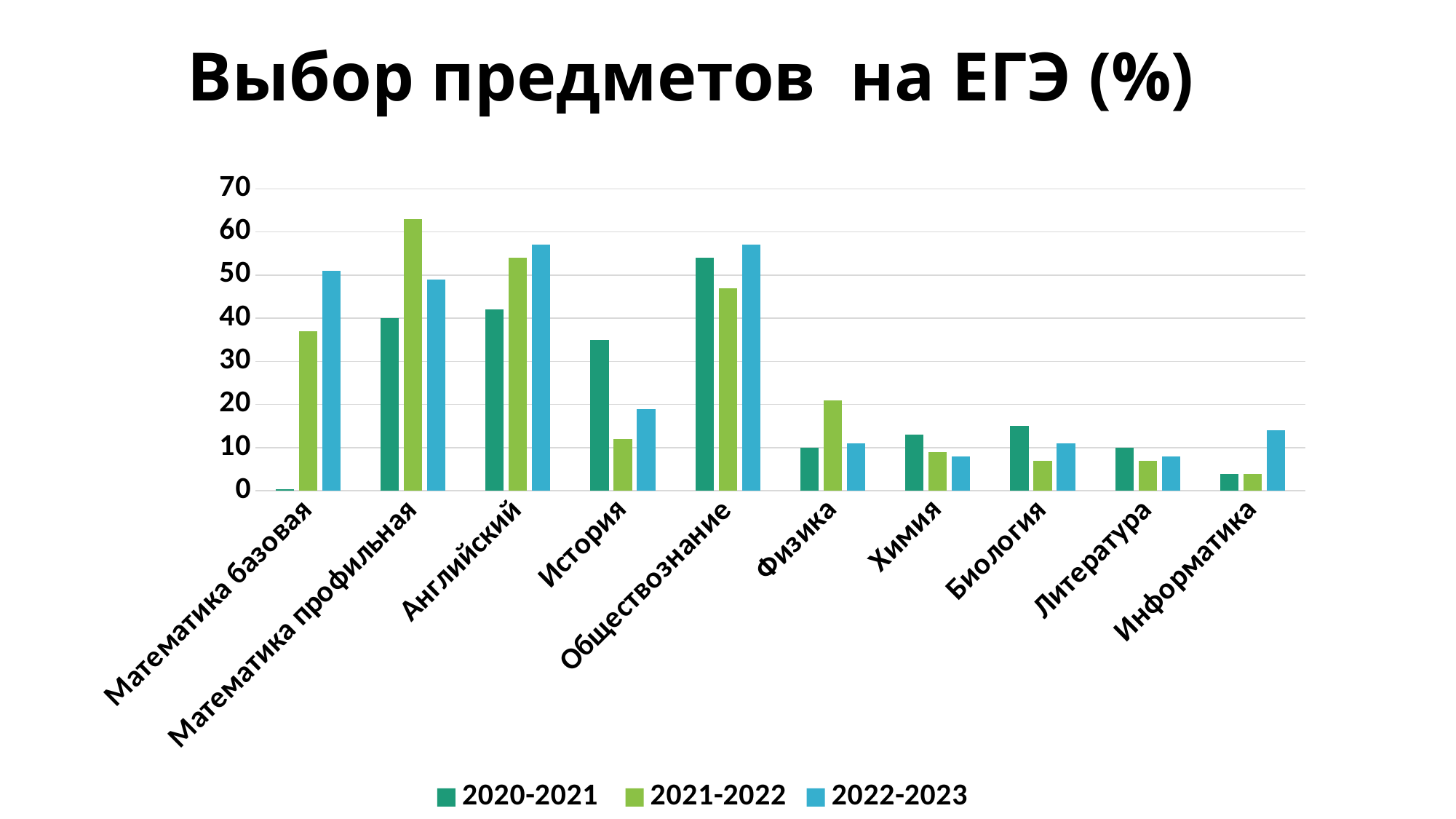
How many subject categories are shown on the x axis? 10 Which subject has the lowest value in the 2020-2021 series? Математика базовая What is the title of the chart? Выбор предметов на ЕГЭ (%) Do the values for Математика базовая rise or fall from 2020-2021 to 2022-2023? rise What kind of chart is shown on the slide? bar chart Is the value for Математика профильная in 2021-2022 greater or less than 60? greater How many series does the legend list? 3 For Обществознание, which series has the larger value: 2021-2022 or 2022-2023? 2022-2023 For Информатика, which series has the larger value: 2020-2021 or 2022-2023? 2022-2023 Which series does the legend list last? 2022-2023 Which subject has the tallest bar in the 2021-2022 series? Математика профильная